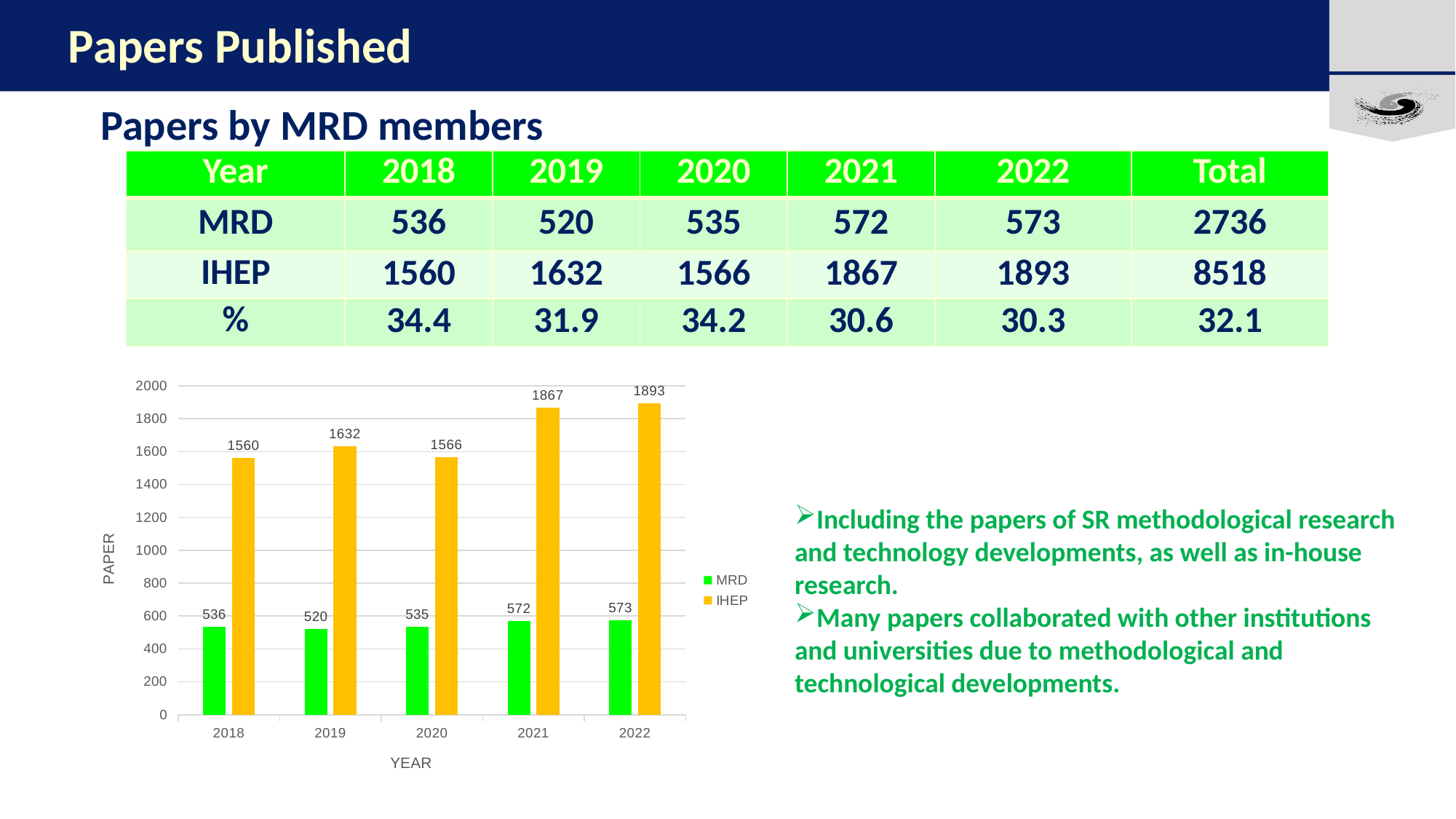
Does the MRD value rise or fall from 2020 to 2022 in the chart? rise What kind of chart is shown on the slide? bar chart What is the difference between the IHEP and MRD values for 2018 in the chart? 1024 How many series does the chart legend list? 2 Which is larger in the chart: the IHEP value for 2019 or the IHEP value for 2020? 2019 Is the IHEP value for 2022 greater or less than 1800? greater What is the MRD value for 2019 in the chart? 520 What is the label of the y axis of the chart? PAPER Which year has the highest IHEP value in the chart? 2022 What is the IHEP value for 2021 in the chart? 1867 How many years are shown on the x axis of the chart? 5 Which year has the lowest MRD value in the chart? 2019